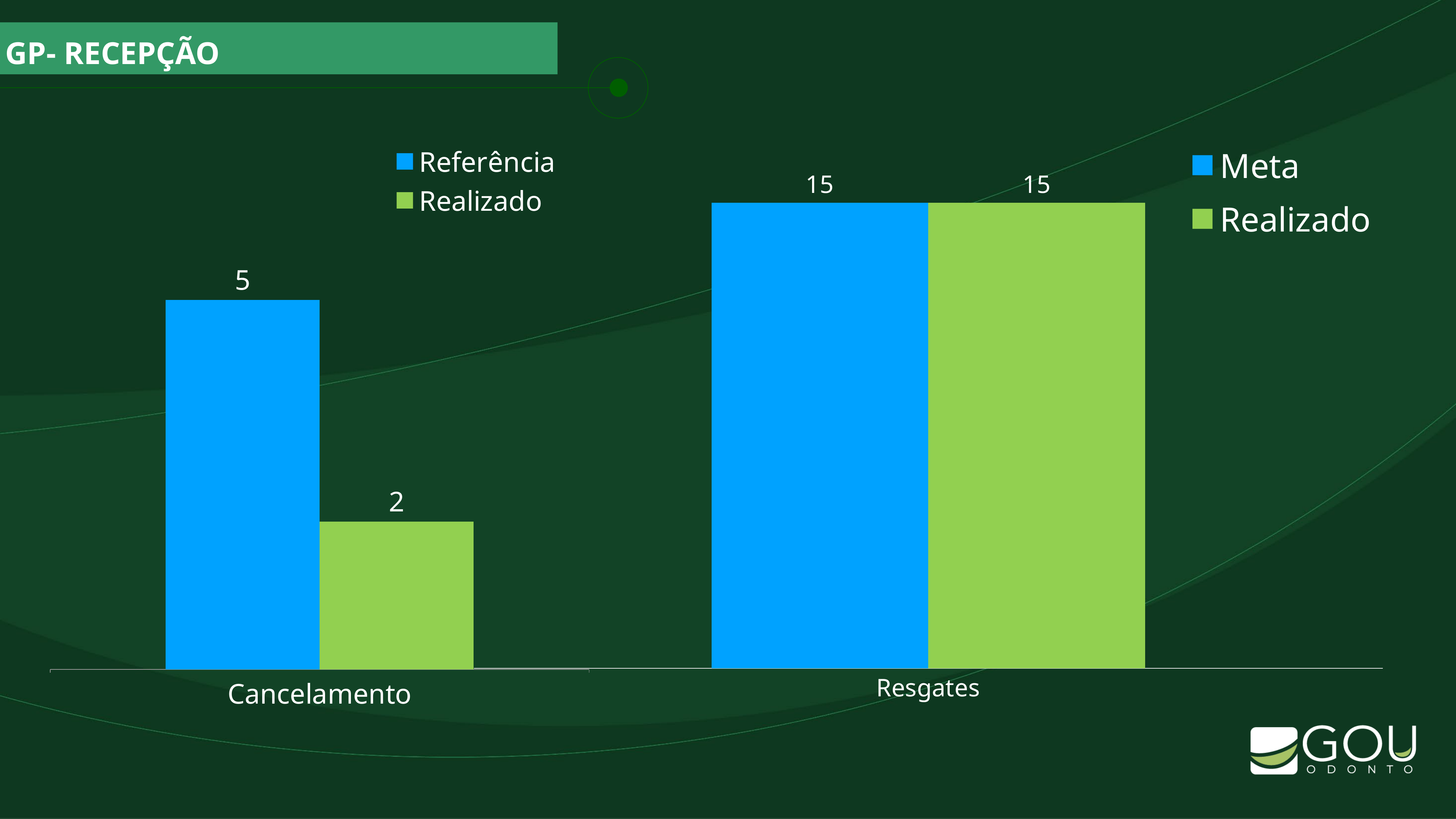
In the left chart (Cancelamento), which is larger, Referência or Realizado? Referência What are the legend entries of the right chart (Resgates)? Meta, Realizado What kind of chart is the left chart (Cancelamento)? Bar chart What colour is the Realizado series in the left chart (Cancelamento)? Green In the right chart (Resgates), what is the value of the Realizado bar? 15 How many series does the legend of the left chart (Cancelamento) list? 2 In the left chart (Cancelamento), what is the value of the Referência bar? 5 How many series does the legend of the right chart (Resgates) list? 2 In the left chart (Cancelamento), what is the difference between the Referência and Realizado values? 3 In the right chart (Resgates), what is the value of the Meta bar? 15 In the right chart (Resgates), what is the difference between the Meta and Realizado values? 0 In the left chart (Cancelamento), what is the value of the Realizado bar? 2